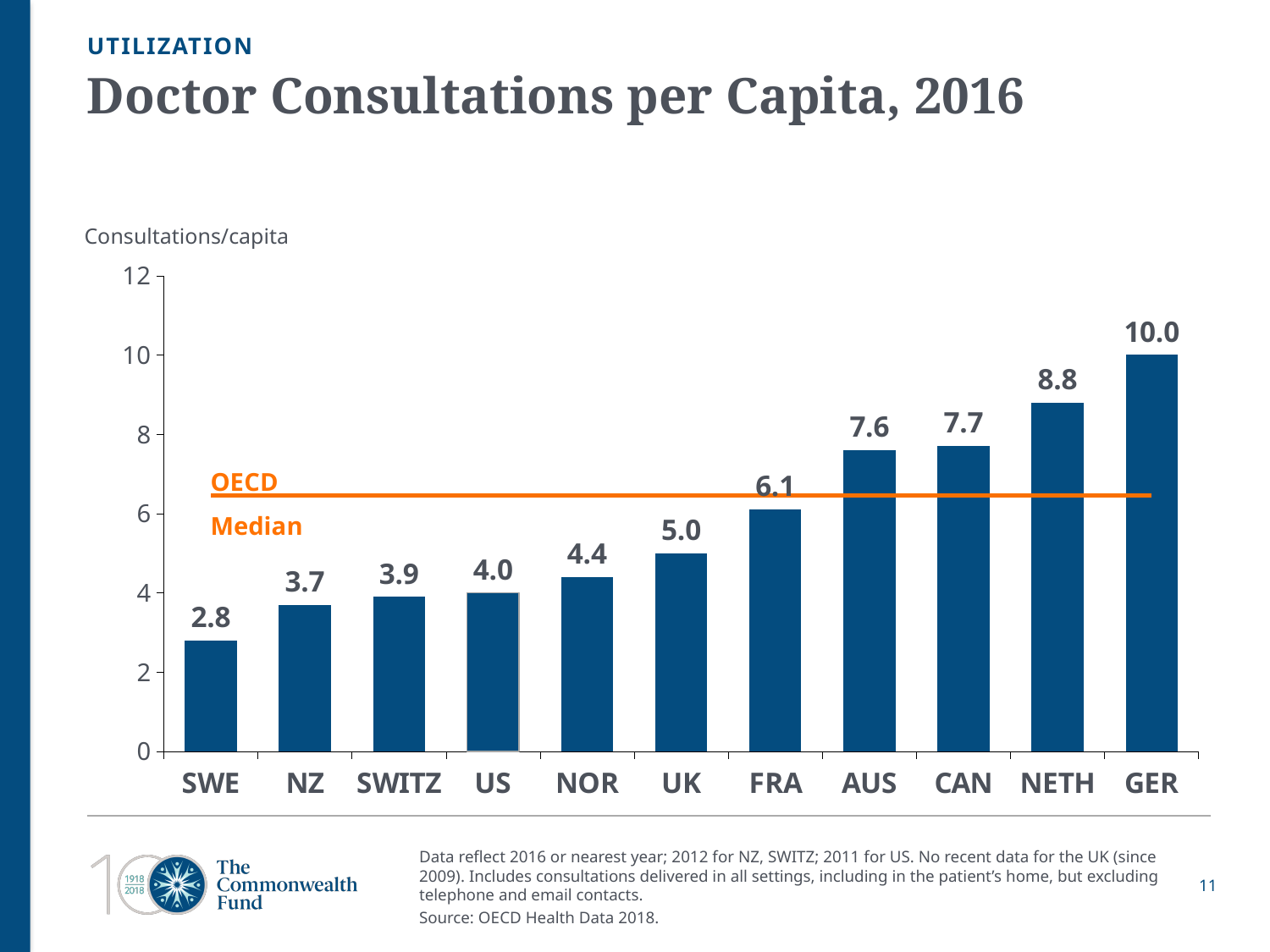
What does the orange horizontal line represent? OECD Median Which is larger, the value for UK or the value for NOR? UK Which country has the lowest number of doctor consultations per capita? SWE How many countries are shown in the chart? 11 Which country has the highest number of doctor consultations per capita? GER Is the value for FRA greater or less than 6? greater What is the value for NETH? 8.8 What is the value for the US? 4.0 What kind of chart is this? bar chart What is the difference between the values for CAN and AUS? 0.1 What is the difference between the values for GER and SWE? 7.2 Do the values rise or fall from left to right along the x axis? rise